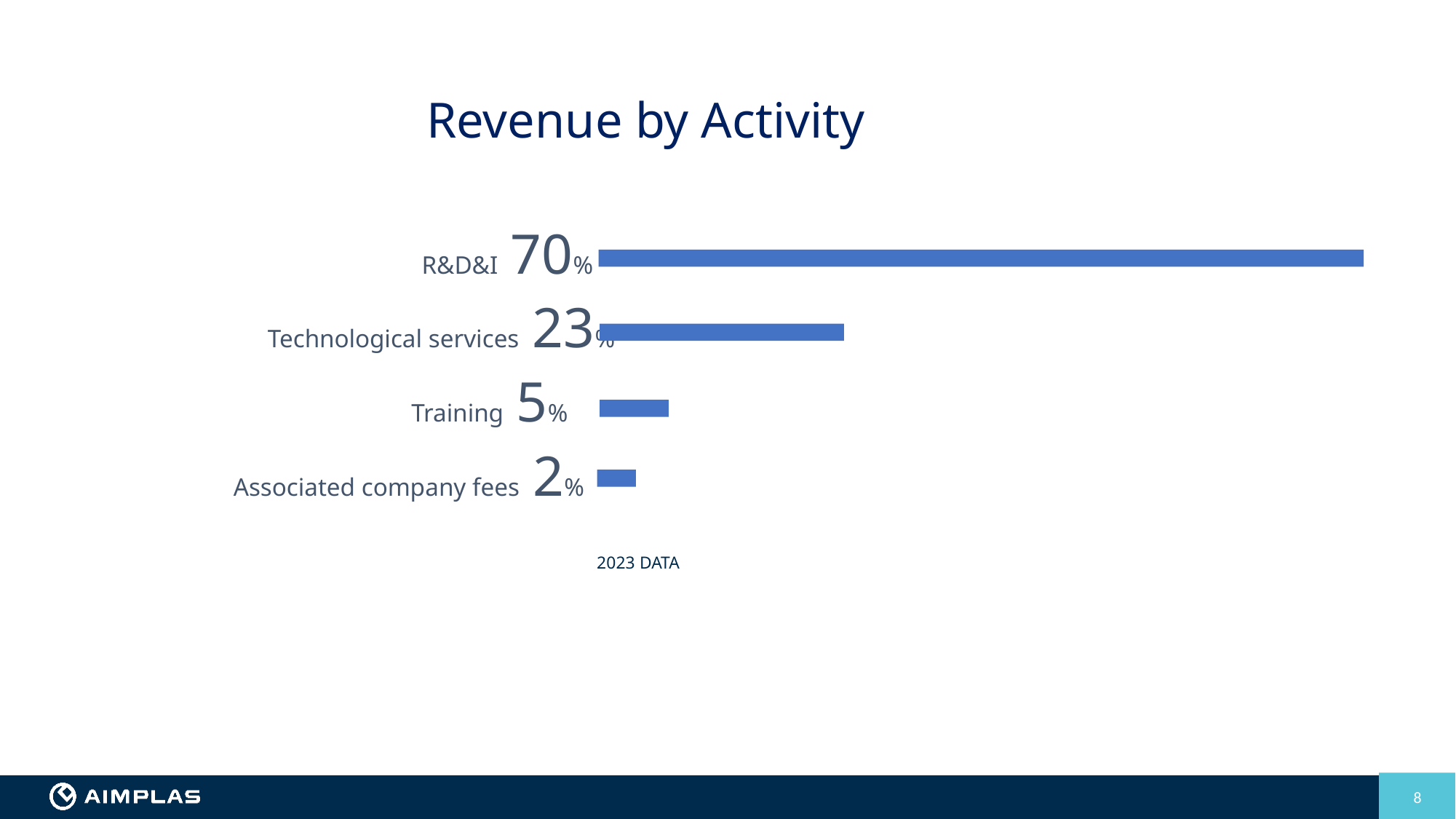
How many activities are shown in the chart? 4 What year does the chart's data refer to? 2023 What is the difference in percentage points between R&D&I and Technological services? 47 Which has a larger revenue share, Technological services or Training? Technological services What is the revenue share for Associated company fees? 2% What is the revenue share for Technological services? 23% What kind of chart is shown on the slide? Bar chart What is the revenue share for Training? 5% Which activity has the lowest revenue share? Associated company fees What is the difference in percentage points between Training and Associated company fees? 3 Which activity has the highest revenue share? R&D&I What is the revenue share for R&D&I? 70%